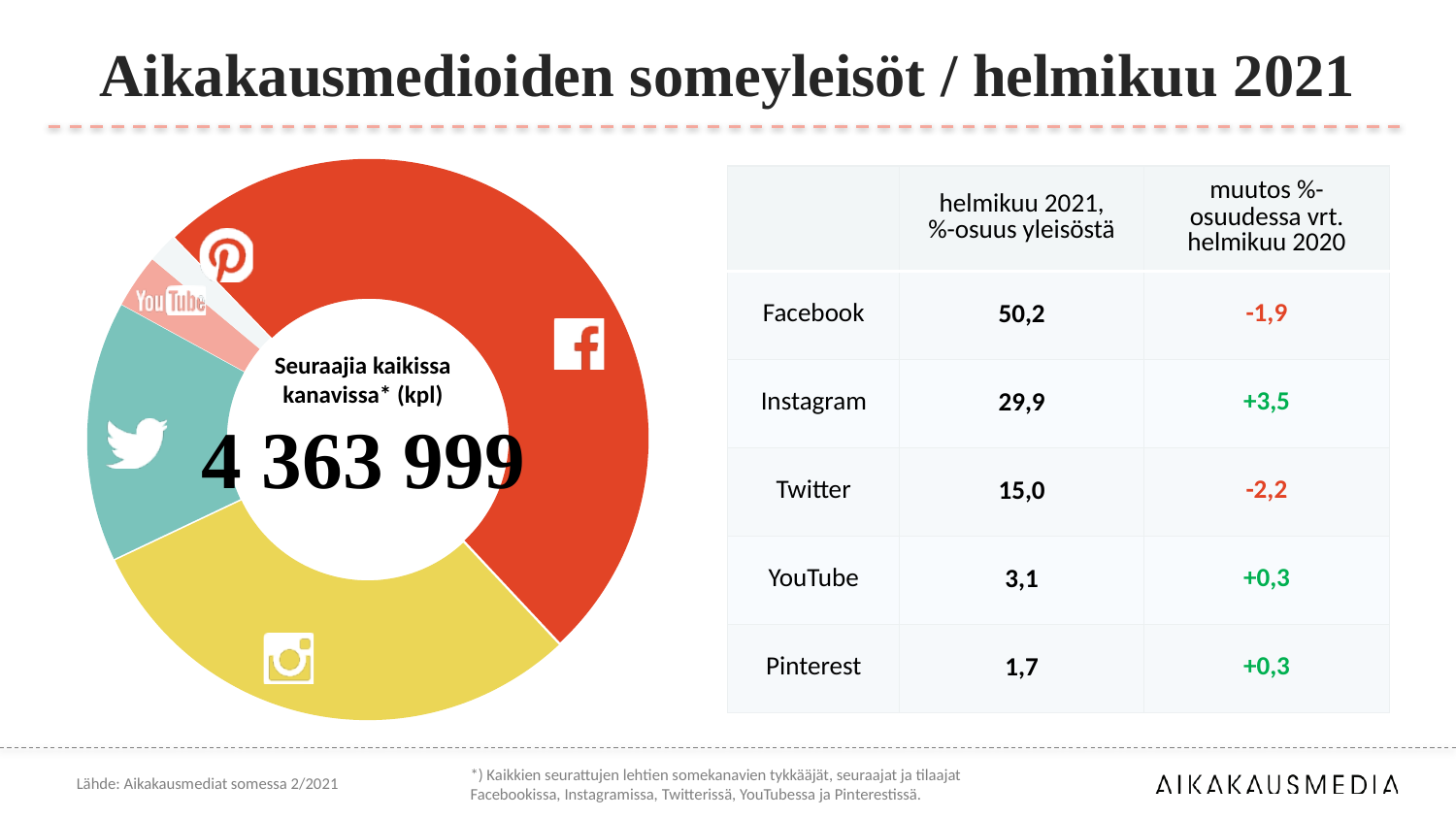
What colour is the Instagram slice in the donut chart? Yellow What is the difference in percentage share between Facebook and Instagram in February 2021? 20,3 How many social media channels are shown as slices in the donut chart? 5 According to the table, what is Instagram's share of the audience in February 2021? 29,9 According to the table, what is Facebook's share of the audience in February 2021? 50,2 What kind of chart is shown on the left of the slide? Donut (pie) chart What is the change in Instagram's percentage share compared with February 2020? +3,5 Which channel has the smallest slice of the donut chart? Pinterest Which channel has the largest slice of the donut chart? Facebook What total number of followers across all channels is printed in the centre of the donut chart? 4 363 999 What is the change in Twitter's percentage share compared with February 2020? -2,2 Which slice is larger in the donut chart, Twitter or Instagram? Instagram